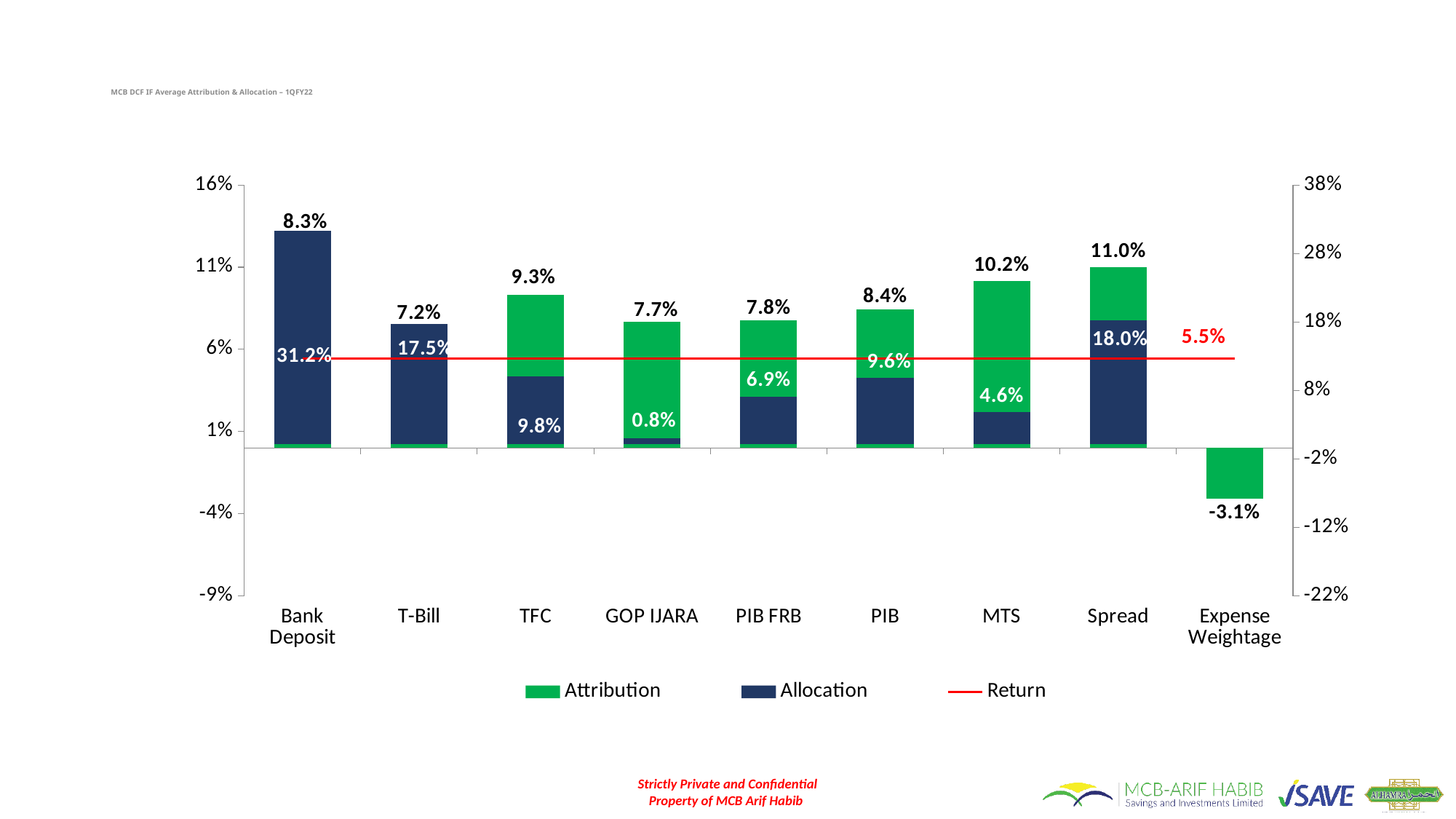
How many series does the legend list? 3 How many categories are shown on the x axis? 9 What is the title of the chart? MCB DCF IF Average Attribution & Allocation – 1QFY22 What is the Attribution value labelled for Spread? 11.0% What kind of chart is this? Bar chart with a line What is the Allocation value labelled for Bank Deposit? 31.2% What is the difference between the Attribution values labelled for Spread and MTS? 0.8% What value is labelled on the Return line? 5.5% What is the Attribution value labelled for Expense Weightage? -3.1% Which has a larger Allocation value, T-Bill or TFC? T-Bill Which category has the highest Attribution value labelled above its bar? Spread Which category has the lowest Allocation value labelled inside its bar? GOP IJARA